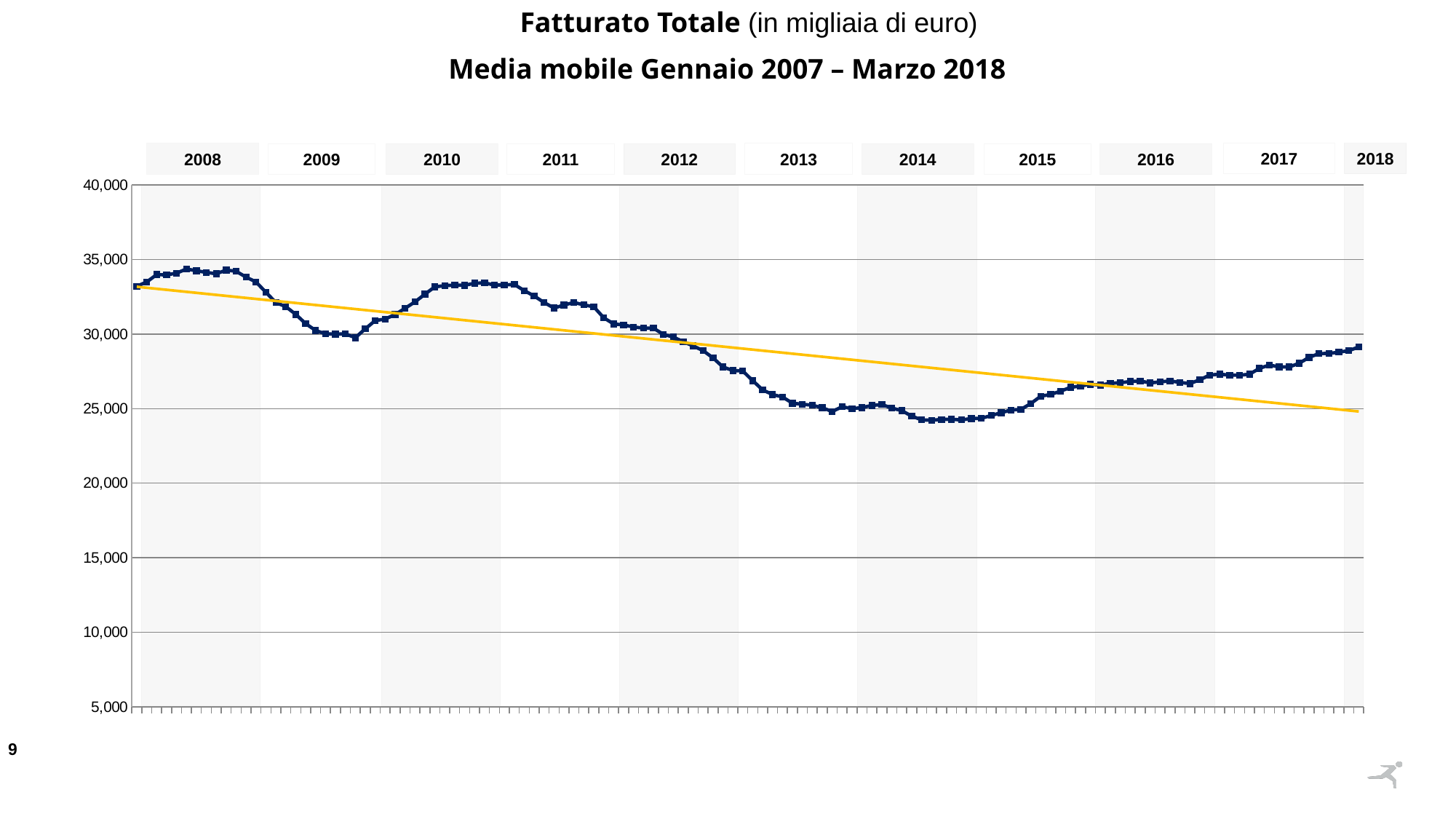
Is the moving average during 2008 greater or less than 30,000? greater How many year labels are shown along the top of the chart? 11 What is the highest value shown on the vertical axis? 40,000 Is the moving average in 2017 greater or less than 25,000? greater Is the moving average during 2013 greater or less than 30,000? less Which is higher, the moving average in 2013 or in 2017? 2017 In which year does the moving average reach its lowest level? 2014 What kind of chart is shown on the slide? line chart What is the title of the chart? Fatturato Totale (in migliaia di euro) Media mobile Gennaio 2007 – Marzo 2018 Does the yellow trend line rise or fall from left to right? fall Which is higher, the moving average in 2008 or in 2014? 2008